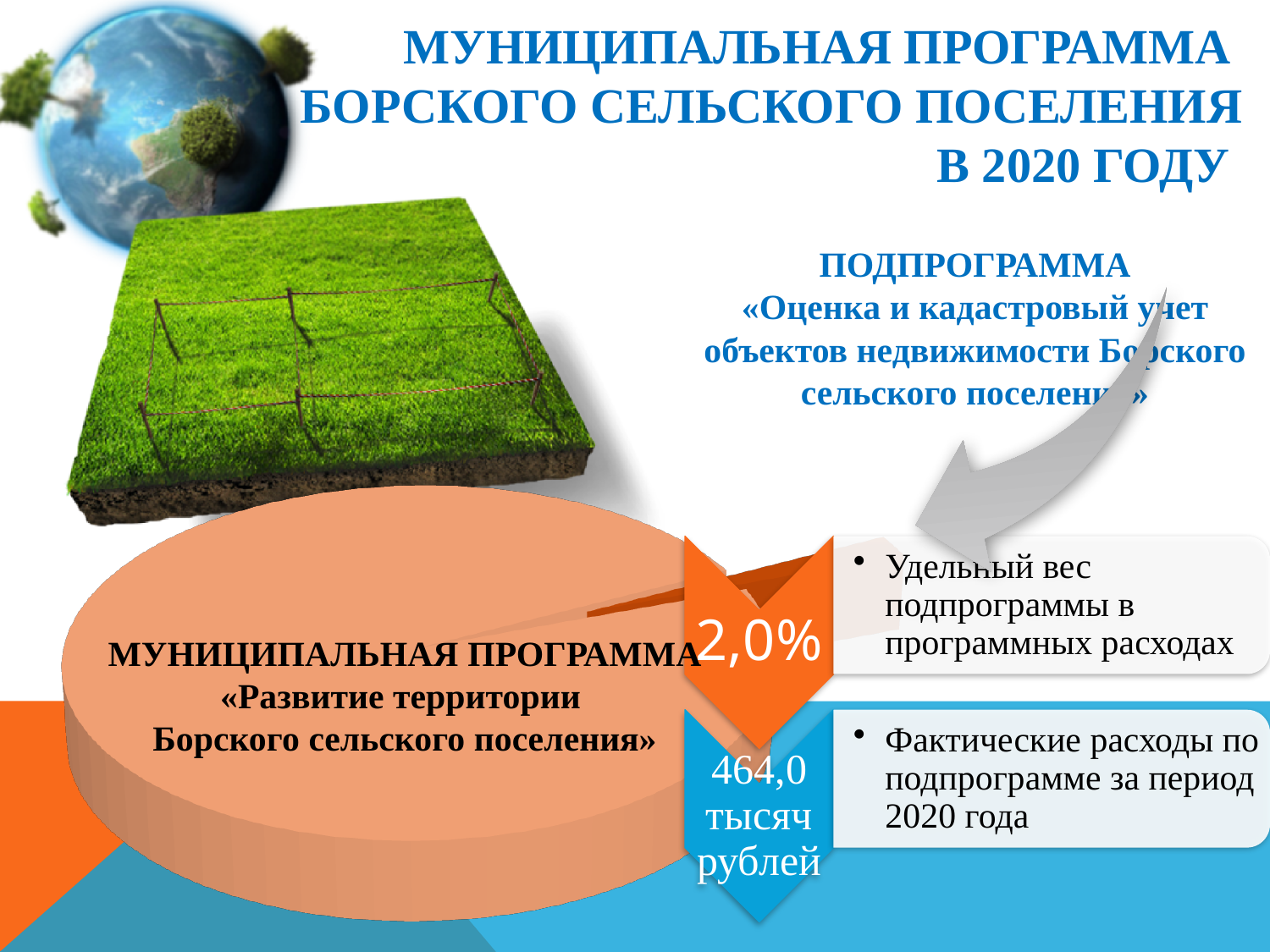
How many slices does the pie chart have? 2 What are the actual expenses on the subprogramme for 2020 shown next to the pie chart? 464,0 тысяч рублей Which slice of the pie chart is the smallest? the subprogramme slice (2,0%) What kind of chart is shown on the slide? pie chart Which slice of the pie chart is larger: the municipal programme «Развитие территории Борского сельского поселения» or the subprogramme slice? the municipal programme «Развитие территории Борского сельского поселения» For which year are the subprogramme expenses in the chart reported? 2020 Is the subprogramme's share in the pie chart greater or less than 50%? less Which municipal programme does the large slice of the pie chart represent? «Развитие территории Борского сельского поселения» What colour is the small exploded slice of the pie chart? orange What share of the programme expenses does the subprogramme «Оценка и кадастровый учет объектов недвижимости Борского сельского поселения» account for, according to the pie chart? 2,0%